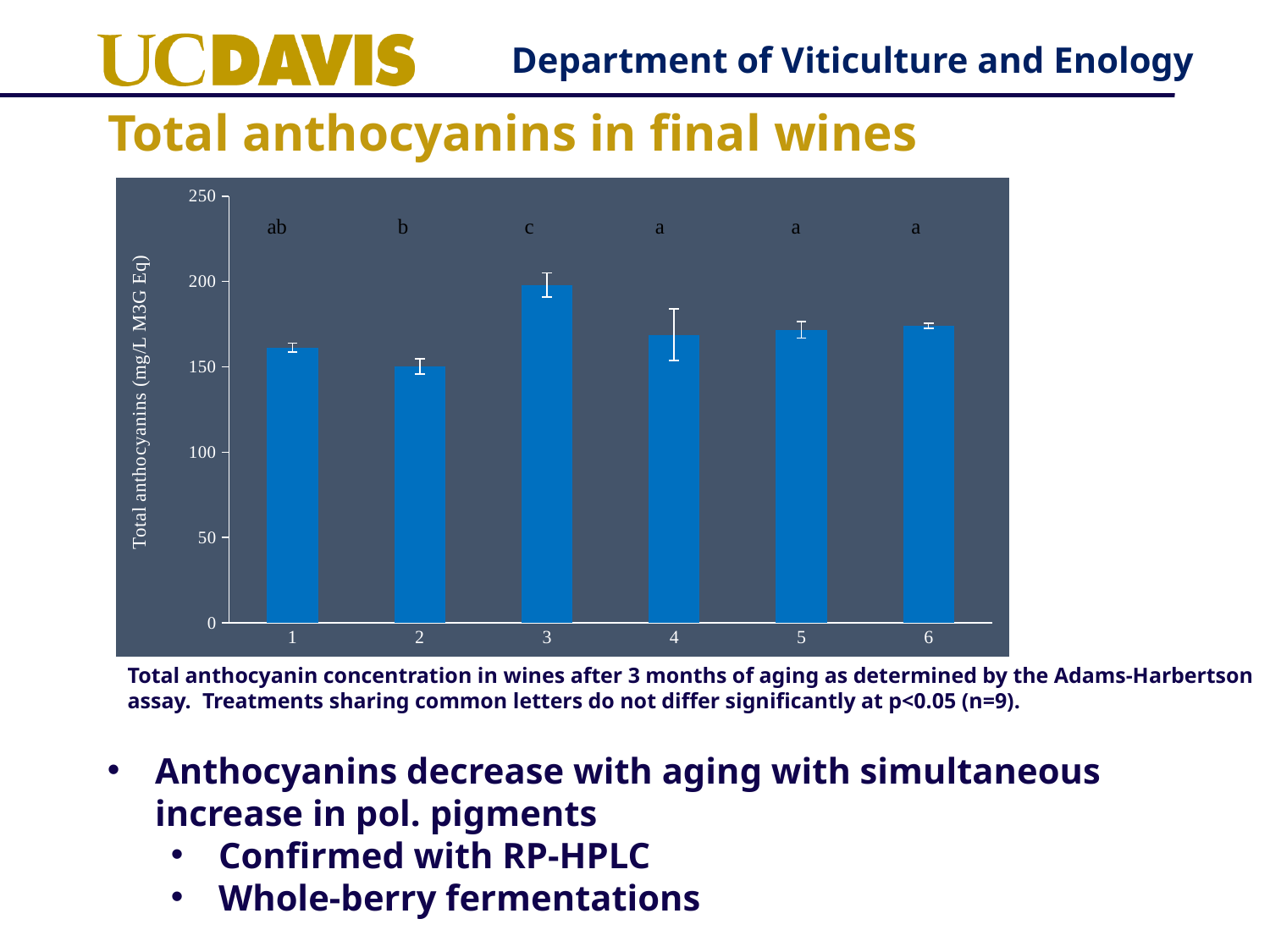
What kind of chart is shown on the slide? bar chart Is the value for treatment 3 greater or less than 250? less Which treatment has the lowest total anthocyanins? 2 How many treatment categories are plotted on the x axis? 6 What significance letter is printed above the bar for treatment 3? c Is the value for treatment 1 greater or less than 200? less Which treatment has the highest total anthocyanins? 3 Is the value for treatment 4 greater or less than 100? greater Which has a higher total anthocyanin value, treatment 2 or treatment 3? treatment 3 What is the label on the y axis of the chart? Total anthocyanins (mg/L M3G Eq) Which has a higher total anthocyanin value, treatment 1 or treatment 3? treatment 3